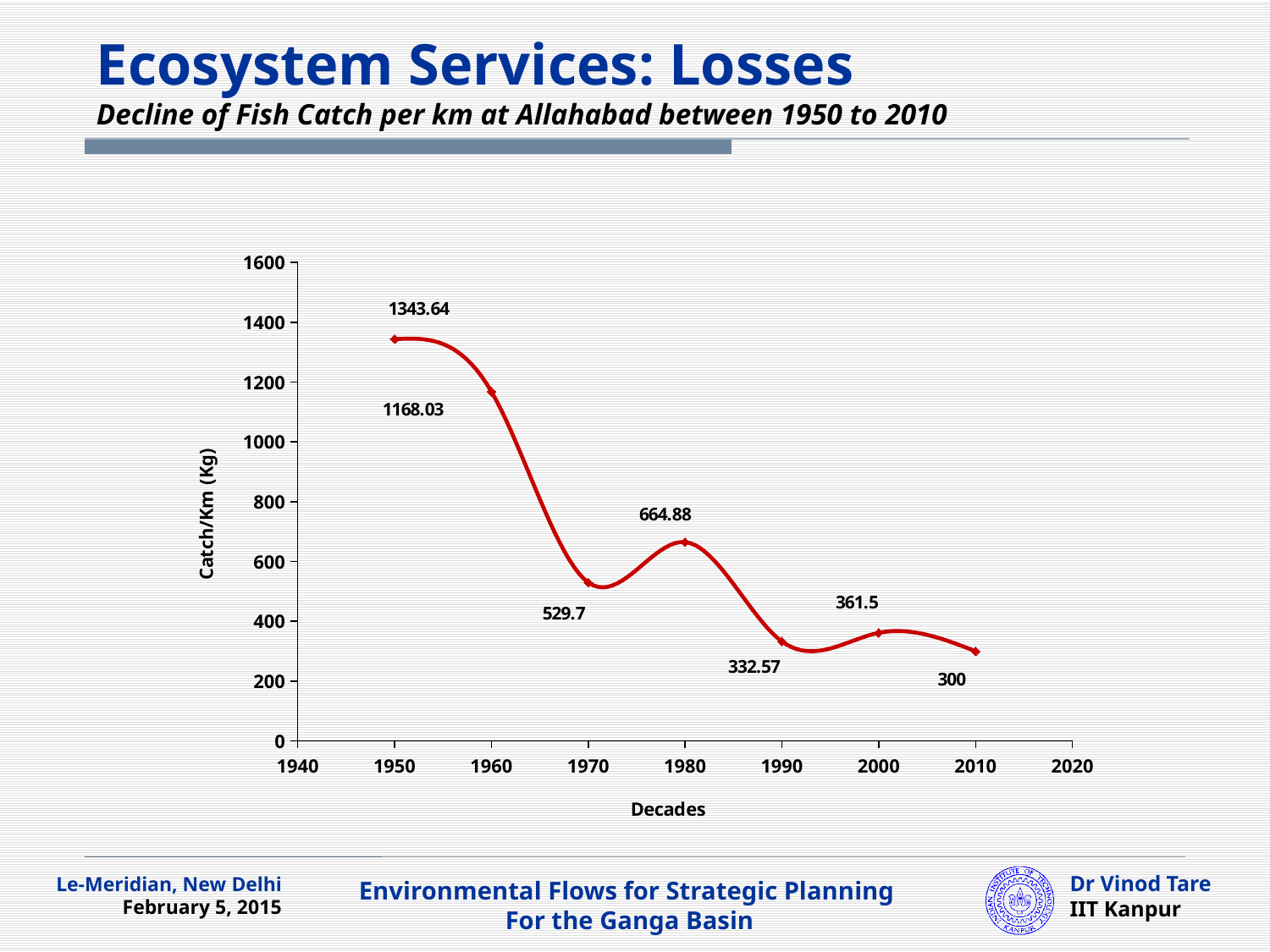
What is the fish catch per km at Allahabad in 1970? 529.7 What is the fish catch per km at Allahabad in 2010? 300 Which is larger, the catch per km in 1980 or in 2000? 1980 Which decade has the highest catch per km? 1950 What is the fish catch per km at Allahabad in 1950? 1343.64 How many data points are plotted on the chart? 7 What is the label of the y axis? Catch/Km (Kg) What is the fish catch per km at Allahabad in 1990? 332.57 What is the difference in catch per km between 1980 and 1970? 135.18 What kind of chart is shown on the slide? line chart Which decade has the lowest catch per km? 2010 What is the difference in catch per km between 1950 and 1960? 175.61